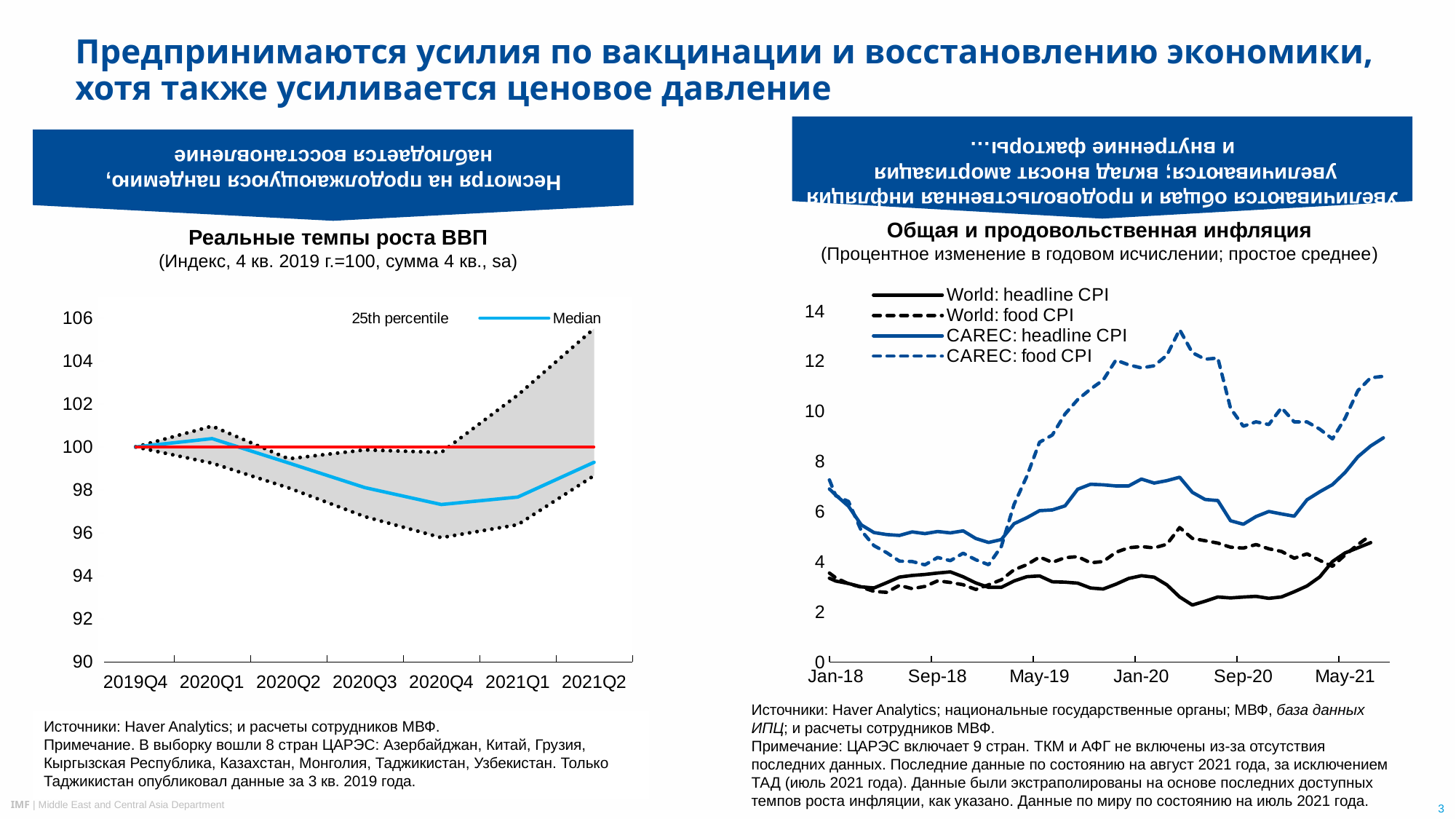
In the left chart ("Реальные темпы роста ВВП"), at what level is the horizontal red reference line drawn? 100 In the right chart ("Общая и продовольственная инфляция"), how many series does the legend list? 4 In the left chart ("Реальные темпы роста ВВП"), is the Median value at 2020Q4 greater or less than 98? less What kind of chart is the right chart titled "Общая и продовольственная инфляция"? Line chart In the left chart ("Реальные темпы роста ВВП"), how many quarters are labelled on the x axis? 7 In the right chart ("Общая и продовольственная инфляция"), which is larger at Sep-20: CAREC: headline CPI or World: headline CPI? CAREC: headline CPI What kind of chart is the left chart titled "Реальные темпы роста ВВП"? Line chart In the right chart ("Общая и продовольственная инфляция"), which series has the highest value at May-21? CAREC: food CPI In the right chart ("Общая и продовольственная инфляция"), is the peak value of CAREC: food CPI greater or less than 12? greater In the left chart ("Реальные темпы роста ВВП"), does the Median line rise or fall from 2019Q4 to 2020Q4? Fall In the left chart ("Реальные темпы роста ВВП"), what is the value of the Median line at 2019Q4? 100 In the right chart ("Общая и продовольственная инфляция"), which series is drawn as a dashed blue line? CAREC: food CPI